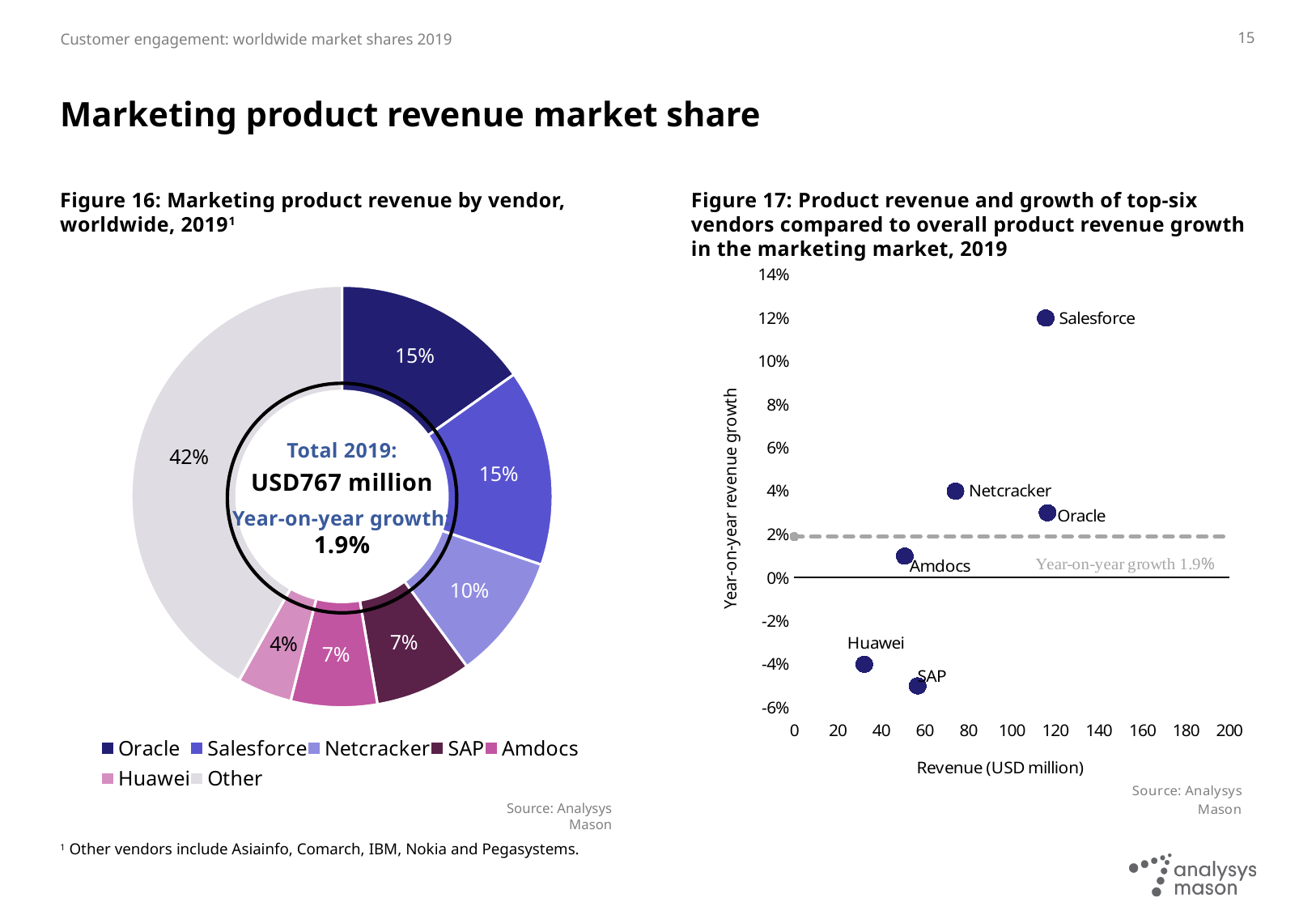
In Figure 16, how many percentage points larger is the Other share than the Oracle share? 27 percentage points In Figure 17, which vendor has the highest year-on-year revenue growth? Salesforce In Figure 17, is Huawei's revenue greater or less than 40 USD million? less What kind of chart is Figure 16? Pie (donut) chart In Figure 17, which vendor has the lowest year-on-year revenue growth? SAP How many vendors are plotted in Figure 17? 6 In Figure 16, which category has the largest slice? Other In Figure 16, what share of revenue does Netcracker hold? 10% In Figure 16, what is the total marketing product revenue for 2019 shown in the centre of the chart? USD767 million How many entries does the legend of Figure 16 list? 7 In Figure 16, which named vendor has the smallest share? Huawei In Figure 16, what share of marketing product revenue is attributed to Other vendors? 42%